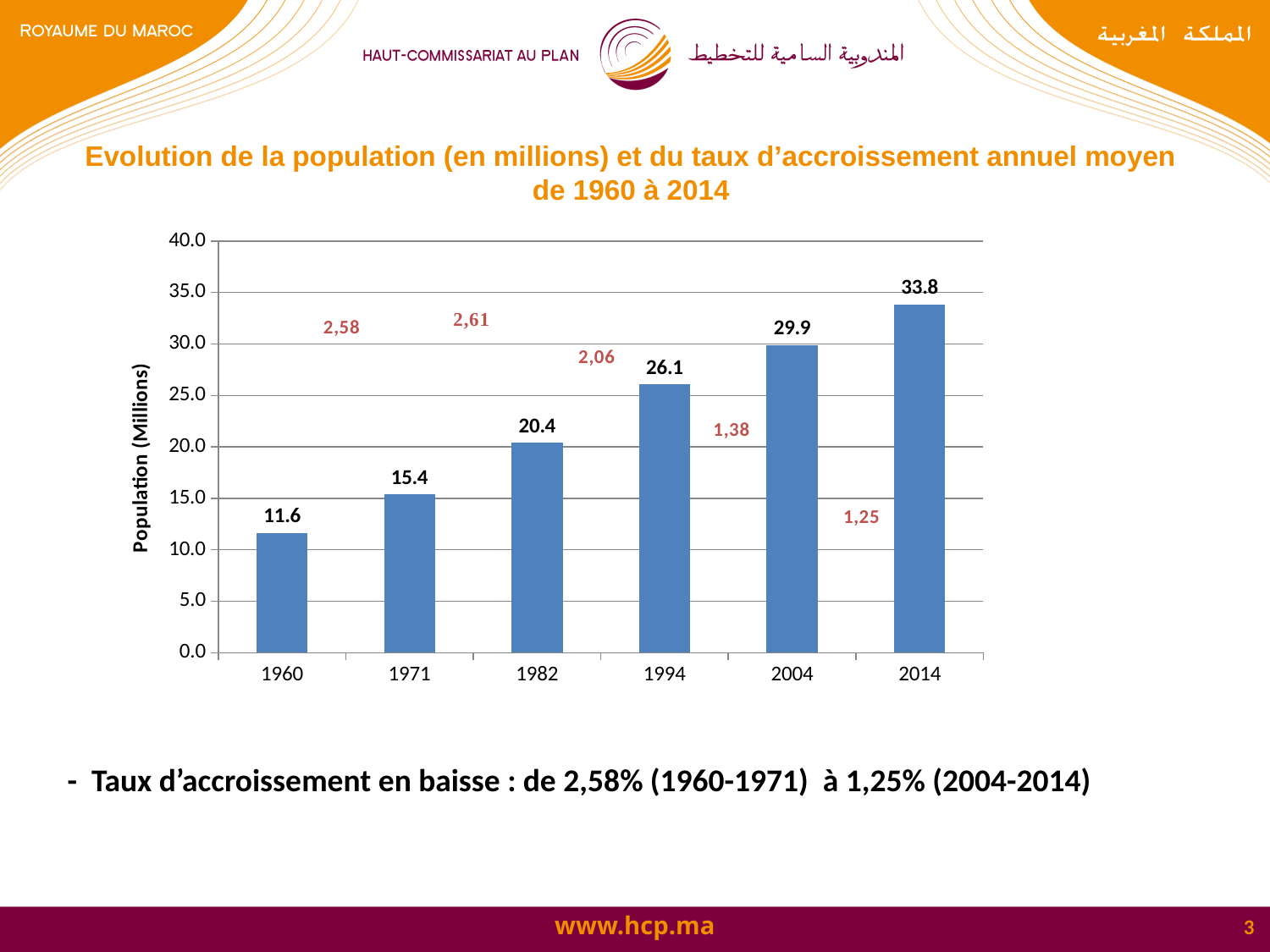
What is the population value shown for 2014? 33.8 Which year has the highest population bar? 2014 Do the population values rise or fall from 1960 to 2014? rise What is the difference between the population values for 1982 and 1971? 5.0 Which is larger, the population value for 1982 or for 1994? 1994 What is the difference between the population values for 2014 and 2004? 3.9 Is the population value for 2004 greater or less than 25.0? greater What is the population value shown for 1960? 11.6 What is the population value shown for 1994? 26.1 How many years are shown on the x axis? 6 Which year has the lowest population bar? 1960 What kind of chart is shown on the slide? bar chart